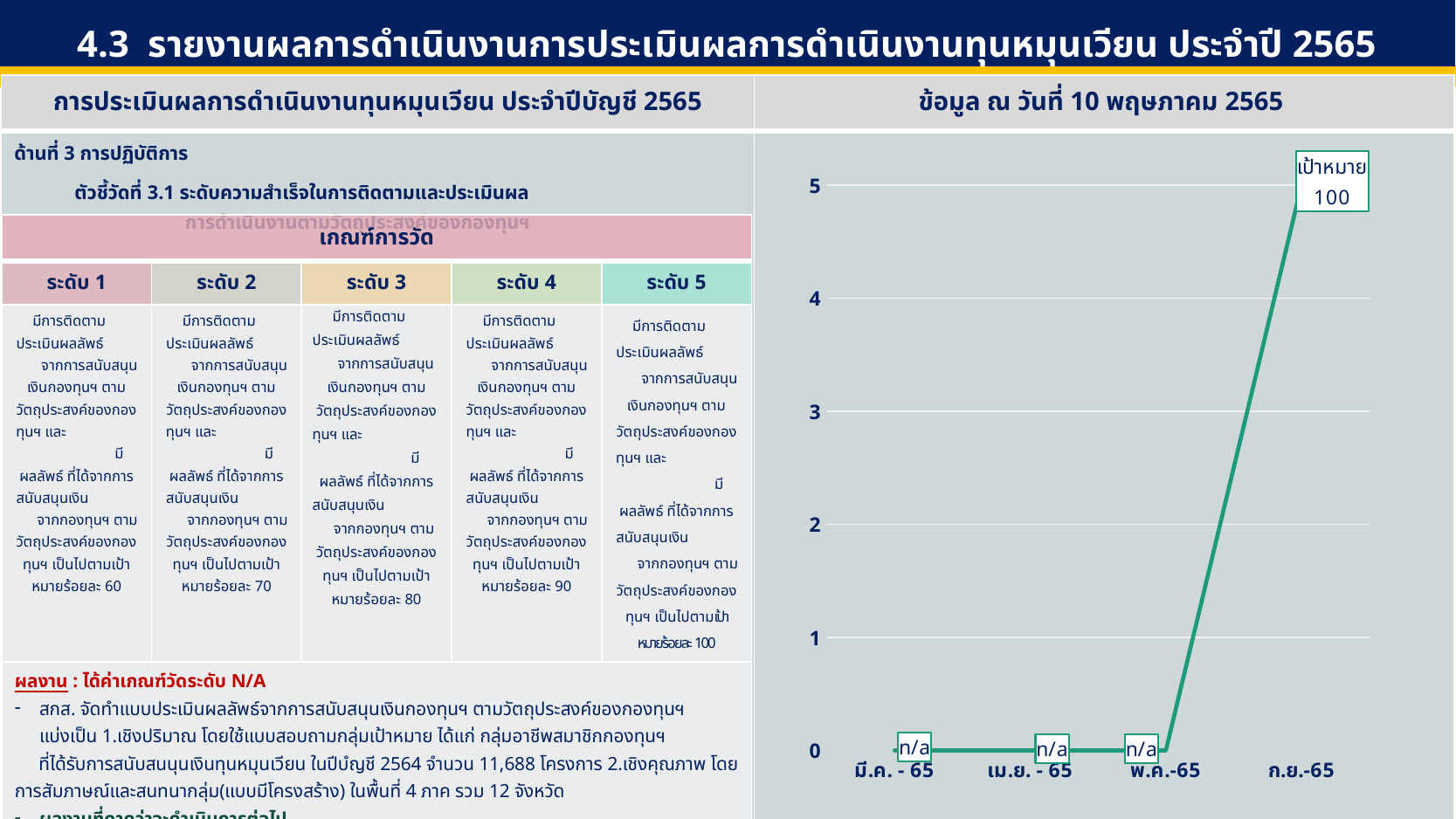
Which category has the highest value in the chart? ก.ย.-65 What data label is shown for มี.ค. - 65 in the chart? n/a What text is shown in the label box next to the last point of the line in the chart? เป้าหมาย 100 What data label is shown for เม.ย. - 65 in the chart? n/a Do the values in the chart rise or fall from left to right along the x axis? rise Is the value for ก.ย.-65 greater or less than 4? greater What kind of chart is shown on the right side of the slide? line chart How many categories are shown on the x axis of the chart? 4 Which is larger in the chart, the value for ก.ย.-65 or the value for พ.ค.-65? ก.ย.-65 What is the highest tick value shown on the y axis of the chart? 5 What data label is shown for พ.ค.-65 in the chart? n/a What is the label of the last category on the x axis of the chart? ก.ย.-65